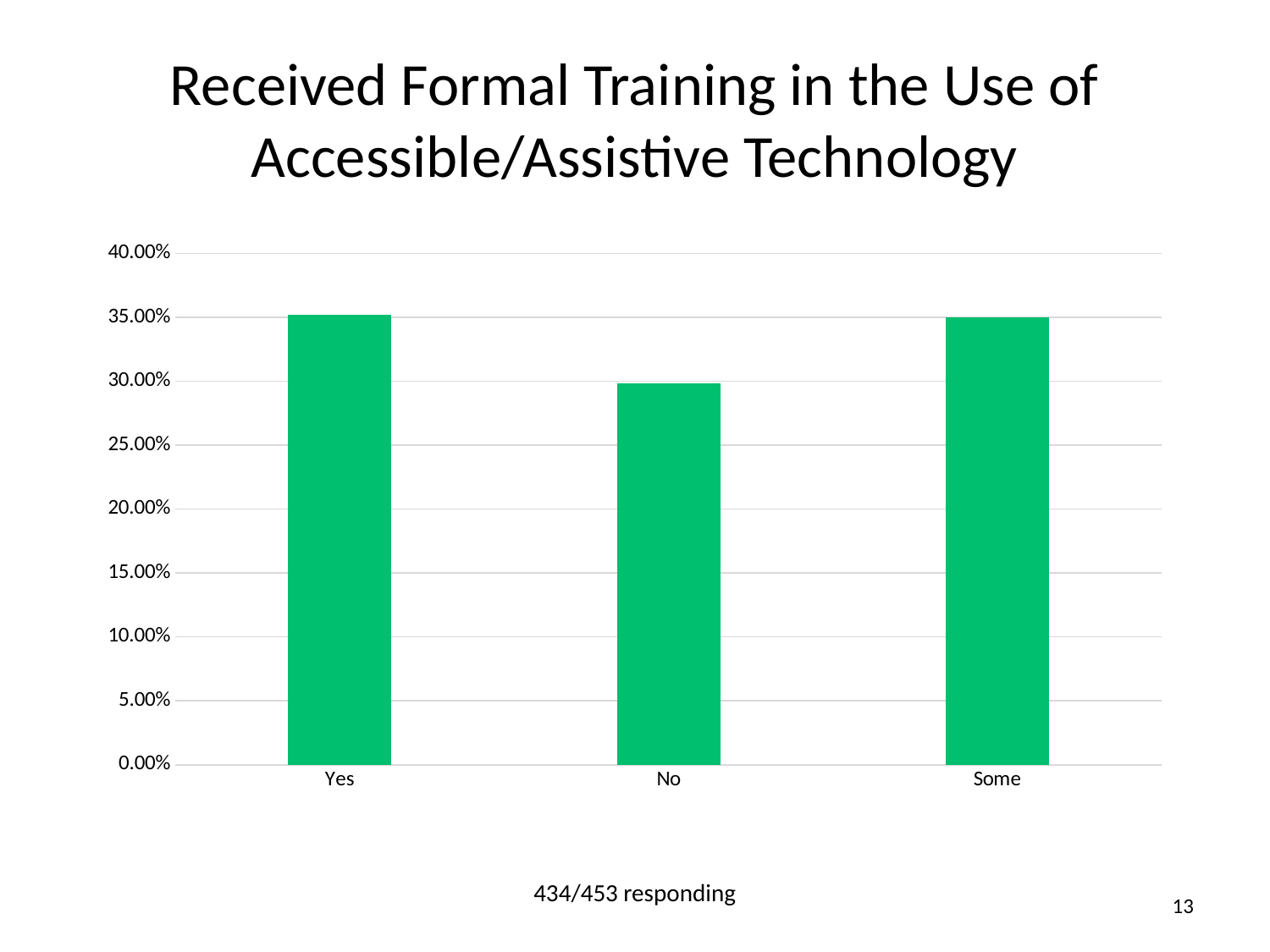
Is the value for Yes greater or less than 40.00%? less What kind of chart is shown on the slide? bar chart Which is larger, the value for Some or the value for No? Some Which is larger, the value for Yes or the value for No? Yes Which category has the lowest value in the chart? No What is the title of the chart on the slide? Received Formal Training in the Use of Accessible/Assistive Technology How many categories are shown on the x axis of the chart? 3 Is the value for No greater or less than 35.00%? less Is the value for Some greater or less than 30.00%? greater What is the highest value shown on the y axis of the chart? 40.00%